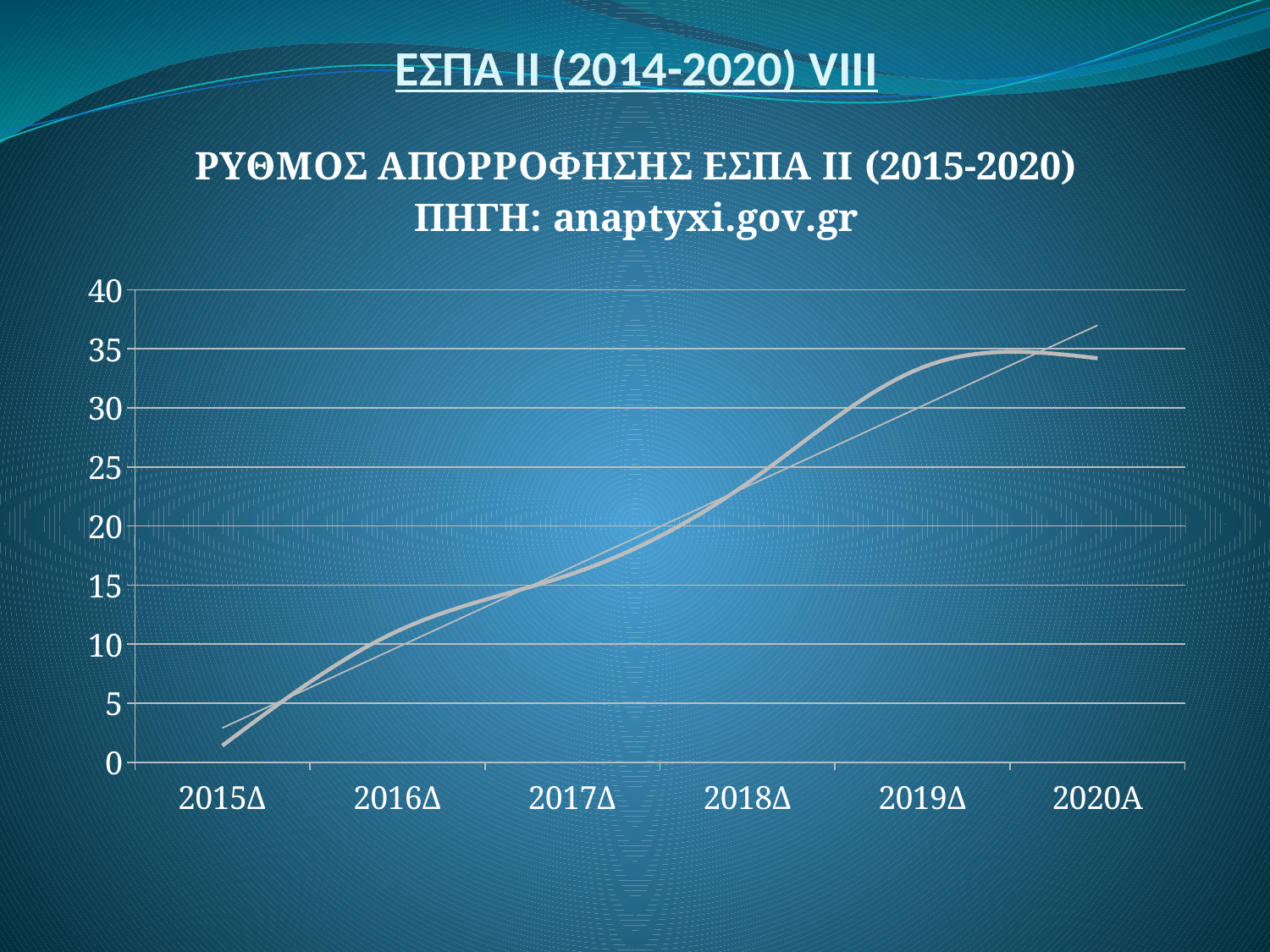
Is the value for 2015Δ greater or less than 5? less How many categories are shown on the x axis of the chart? 6 Is the value for 2018Δ greater or less than 20? greater Is the value for 2016Δ greater or less than 10? greater Do the values in the chart rise or fall from 2015Δ to 2019Δ? rise Which has the larger value, 2016Δ or 2018Δ? 2018Δ What kind of chart is shown on the slide? line chart Which category has the lowest value in the chart? 2015Δ What is the highest value shown on the y axis of the chart? 40 What is the title of the chart? ΡΥΘΜΟΣ ΑΠΟΡΡΟΦΗΣΗΣ ΕΣΠΑ ΙΙ (2015-2020) ΠΗΓΗ: anaptyxi.gov.gr